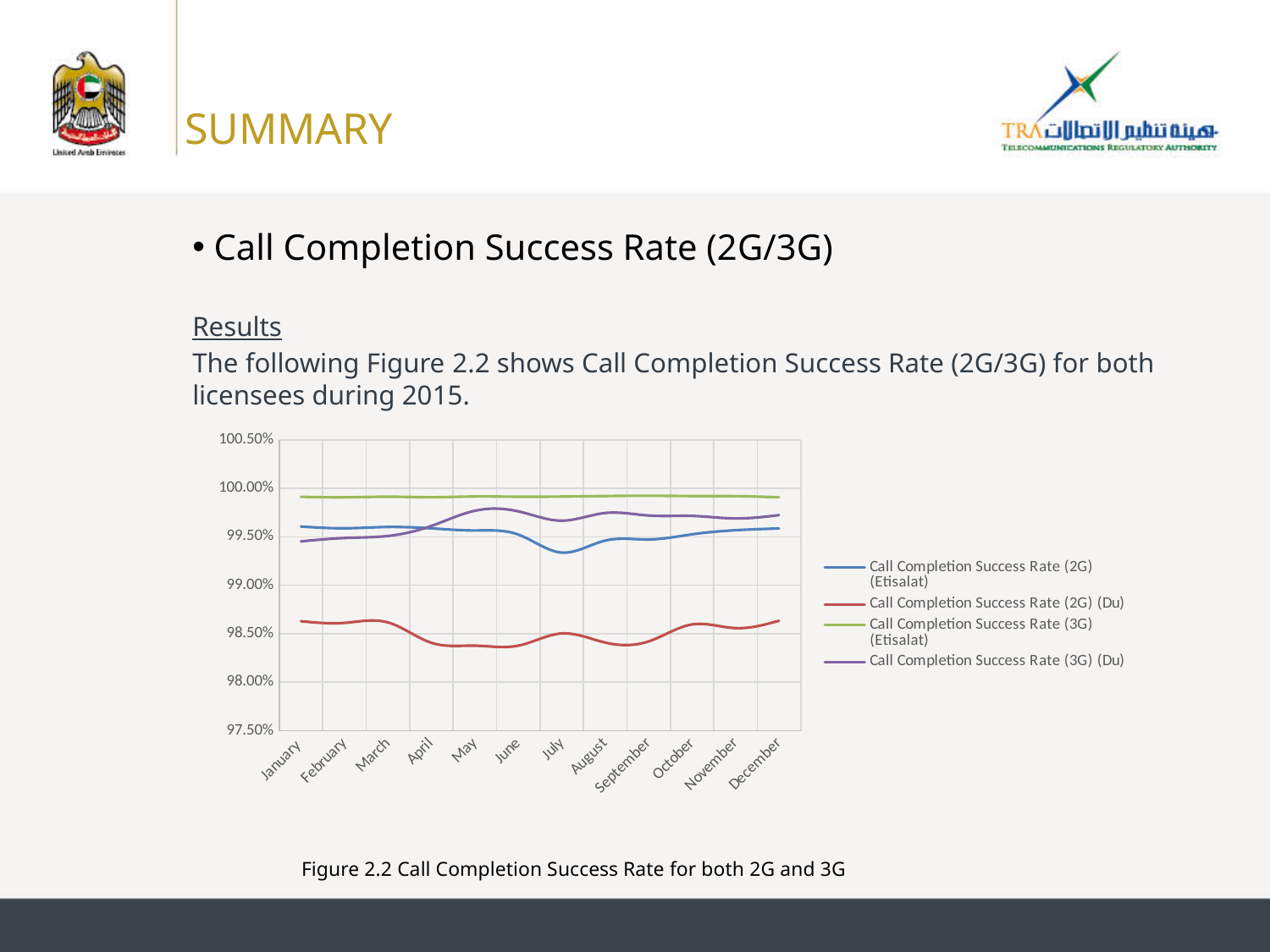
What is the caption given below the chart? Figure 2.2 Call Completion Success Rate for both 2G and 3G Is the value for Call Completion Success Rate (2G) (Du) in January greater or less than 99.00%? less Does the Call Completion Success Rate (2G) (Du) line rise or fall from March to June? fall How many months are plotted along the x axis of the chart? 12 What kind of chart is shown on the slide? line chart How many series does the chart's legend list? 4 Is the value for Call Completion Success Rate (2G) (Du) in June greater or less than 98.50%? less Which series has the lowest value in January? Call Completion Success Rate (2G) (Du) Which series has the highest value in December? Call Completion Success Rate (3G) (Etisalat) Is the value for Call Completion Success Rate (2G) (Etisalat) in July greater or less than 99.50%? less In May, which is higher: Call Completion Success Rate (3G) (Du) or Call Completion Success Rate (2G) (Etisalat)? Call Completion Success Rate (3G) (Du)